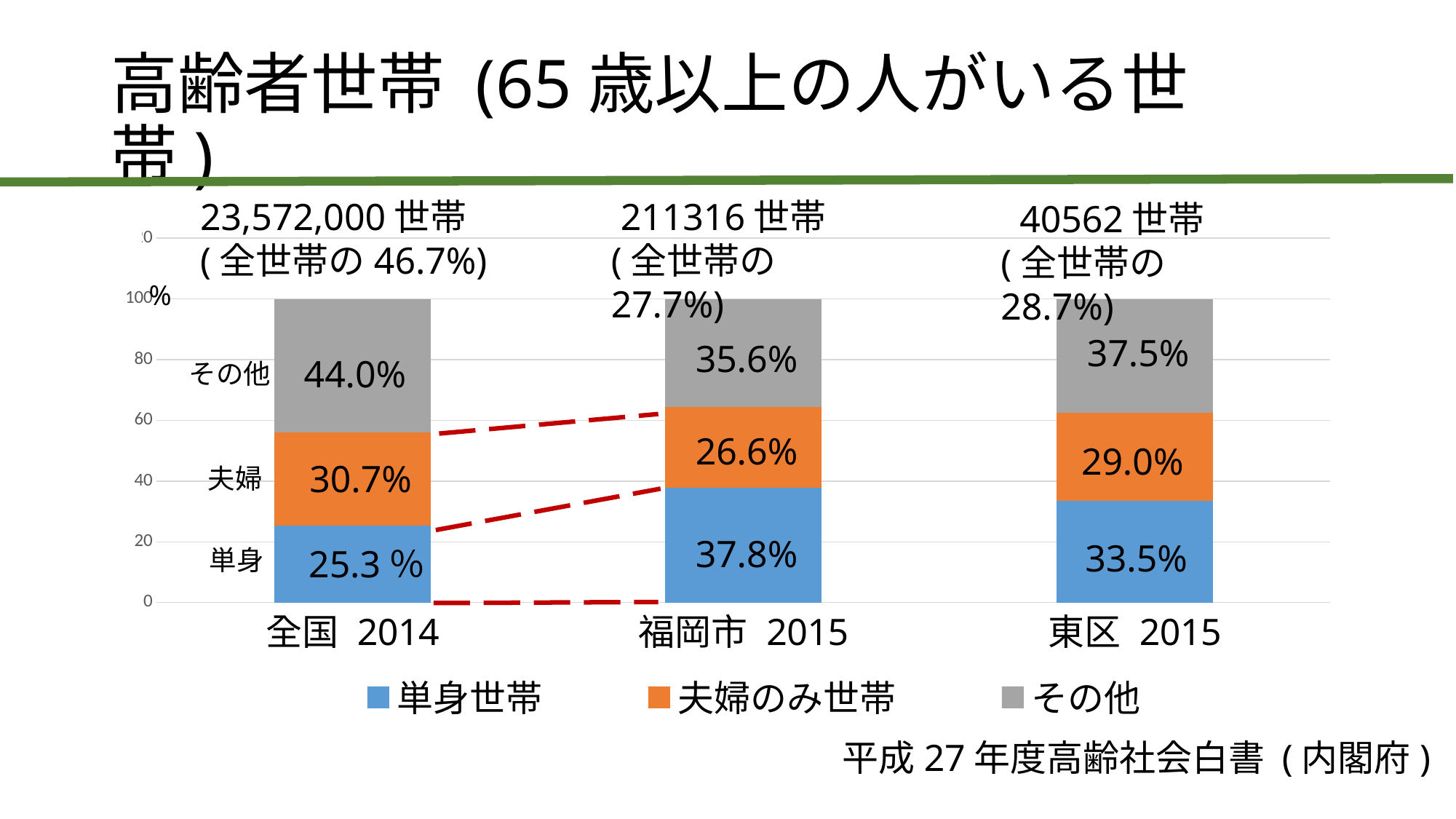
Which is larger: 夫婦のみ世帯 in 全国 2014 or 夫婦のみ世帯 in 東区 2015? 全国 2014 Which category has the lowest value for その他? 福岡市 2015 What is the value for 単身世帯 in 全国 2014? 25.3 % What is the difference between the 単身世帯 values for 福岡市 2015 and 全国 2014? 12.5 percentage points Which colour represents 夫婦のみ世帯 in the chart? Orange What is the value for 夫婦のみ世帯 in 福岡市 2015? 26.6% How many categories are shown on the x axis? 3 What is the value for 単身世帯 in 東区 2015? 33.5% How many series does the legend list? 3 What is the value for その他 in 東区 2015? 37.5% Which category has the highest value for 単身世帯? 福岡市 2015 What kind of chart is shown on the slide? Stacked bar chart